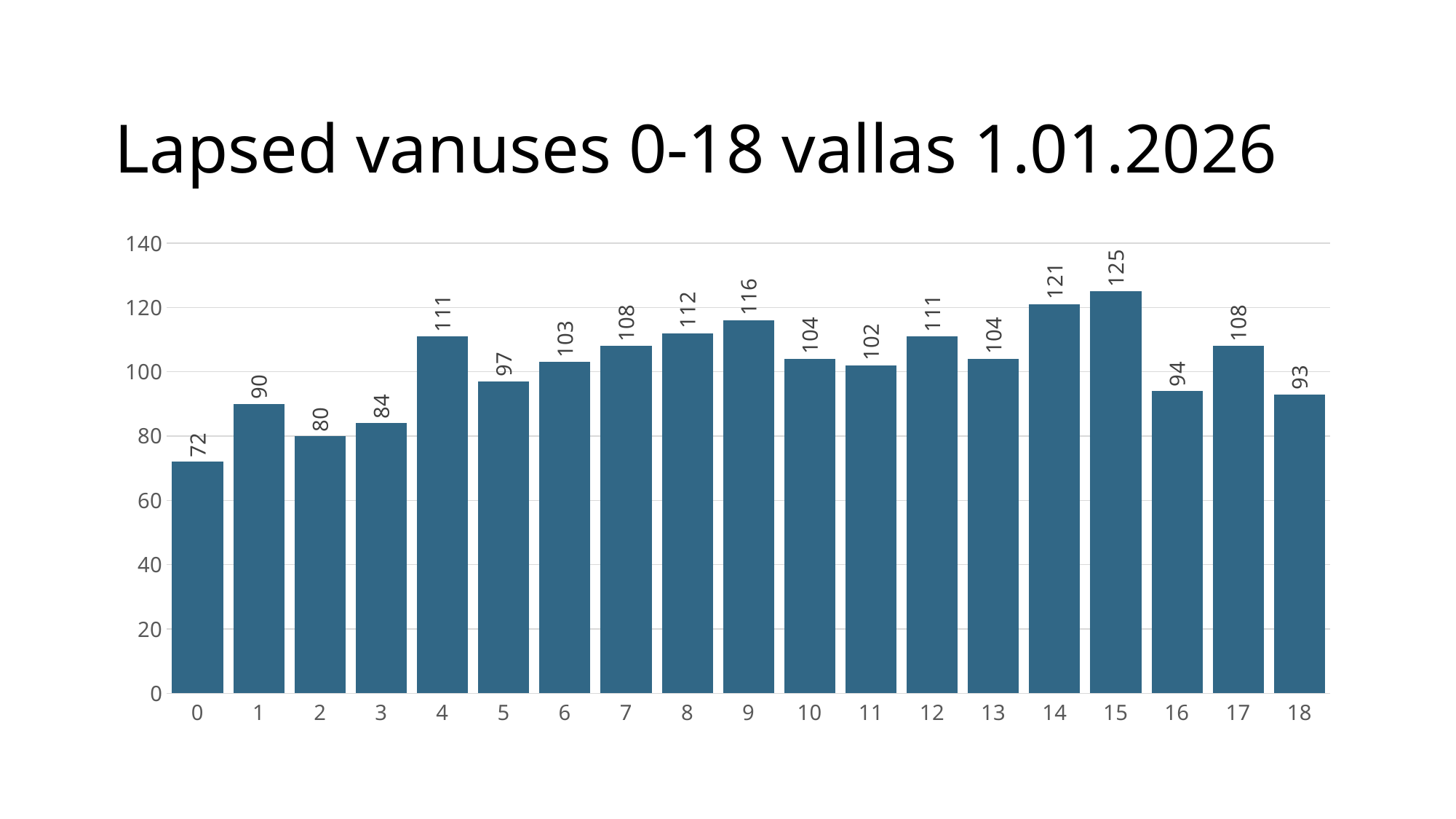
What is the difference between the values for age 14 and age 13? 17 Which age has the lowest value? 0 How many age categories are shown on the x axis? 19 What is the title of the chart? Lapsed vanuses 0-18 vallas 1.01.2026 What kind of chart is shown on the slide? bar chart Which is larger, the value for age 4 or the value for age 5? age 4 What is the value for age 9? 116 Which age has the highest value? 15 What is the value for age 0? 72 What is the value for age 16? 94 Is the value for age 2 greater or less than 100? less What is the difference between the values for age 15 and age 0? 53